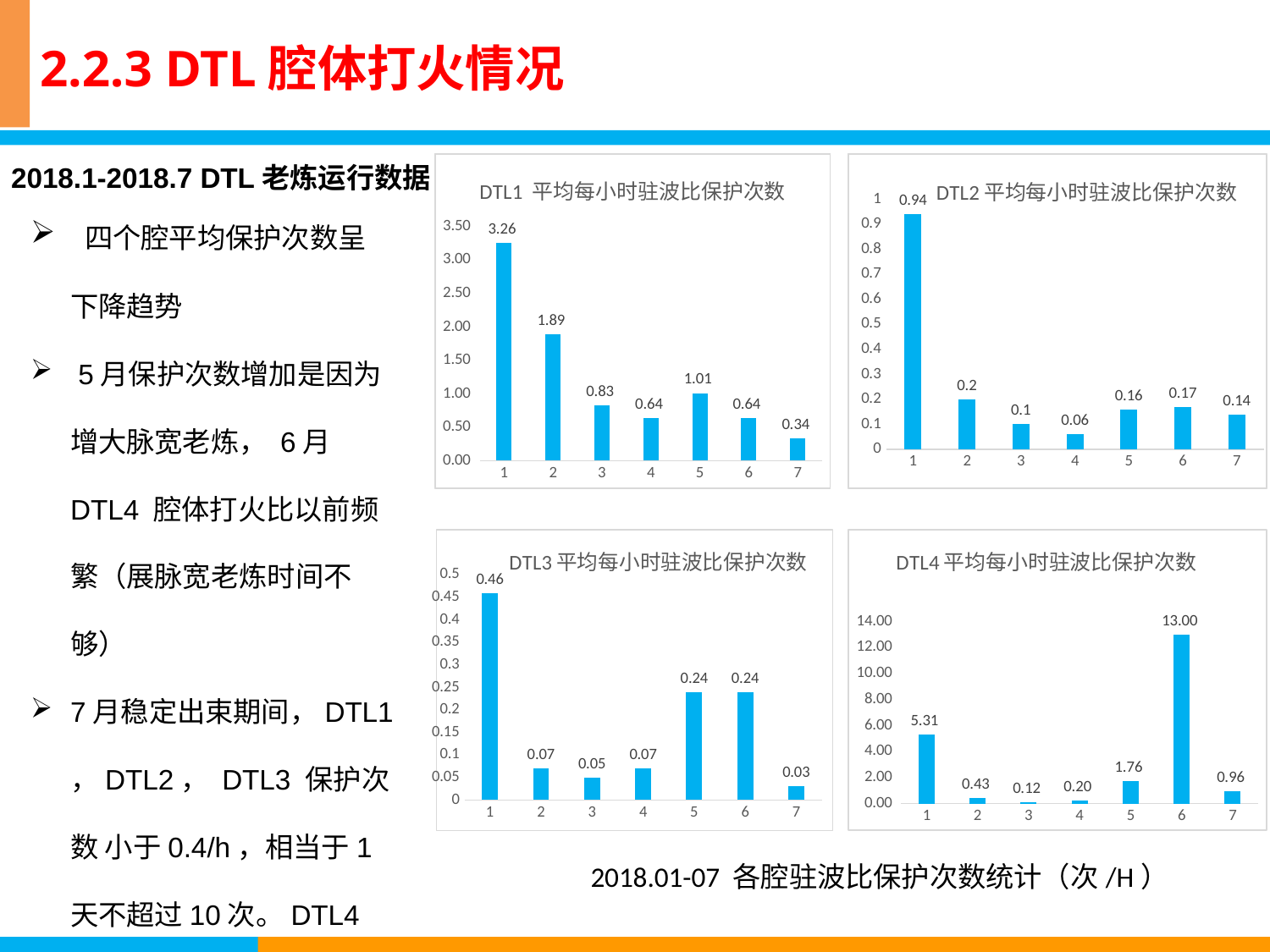
In the DTL1 平均每小时驻波比保护次数 chart, which category has the lowest value? 7 How many categories are shown on the x axis of the DTL4 平均每小时驻波比保护次数 chart? 7 In the DTL2 平均每小时驻波比保护次数 chart, what is the value for category 4? 0.06 In the DTL4 平均每小时驻波比保护次数 chart, what is the difference between the values for category 6 and category 1? 7.69 In the DTL3 平均每小时驻波比保护次数 chart, what is the value for category 5? 0.24 What type of chart is the DTL3 平均每小时驻波比保护次数 chart? bar chart In the DTL2 平均每小时驻波比保护次数 chart, is the value for category 2 larger or smaller than the value for category 5? larger In the DTL3 平均每小时驻波比保护次数 chart, which category has the lowest value? 7 In the DTL1 平均每小时驻波比保护次数 chart, what is the value for category 1? 3.26 In the DTL4 平均每小时驻波比保护次数 chart, what is the value for category 6? 13.00 In the DTL1 平均每小时驻波比保护次数 chart, what is the difference between the values for category 1 and category 2? 1.37 In the DTL2 平均每小时驻波比保护次数 chart, which category has the highest value? 1